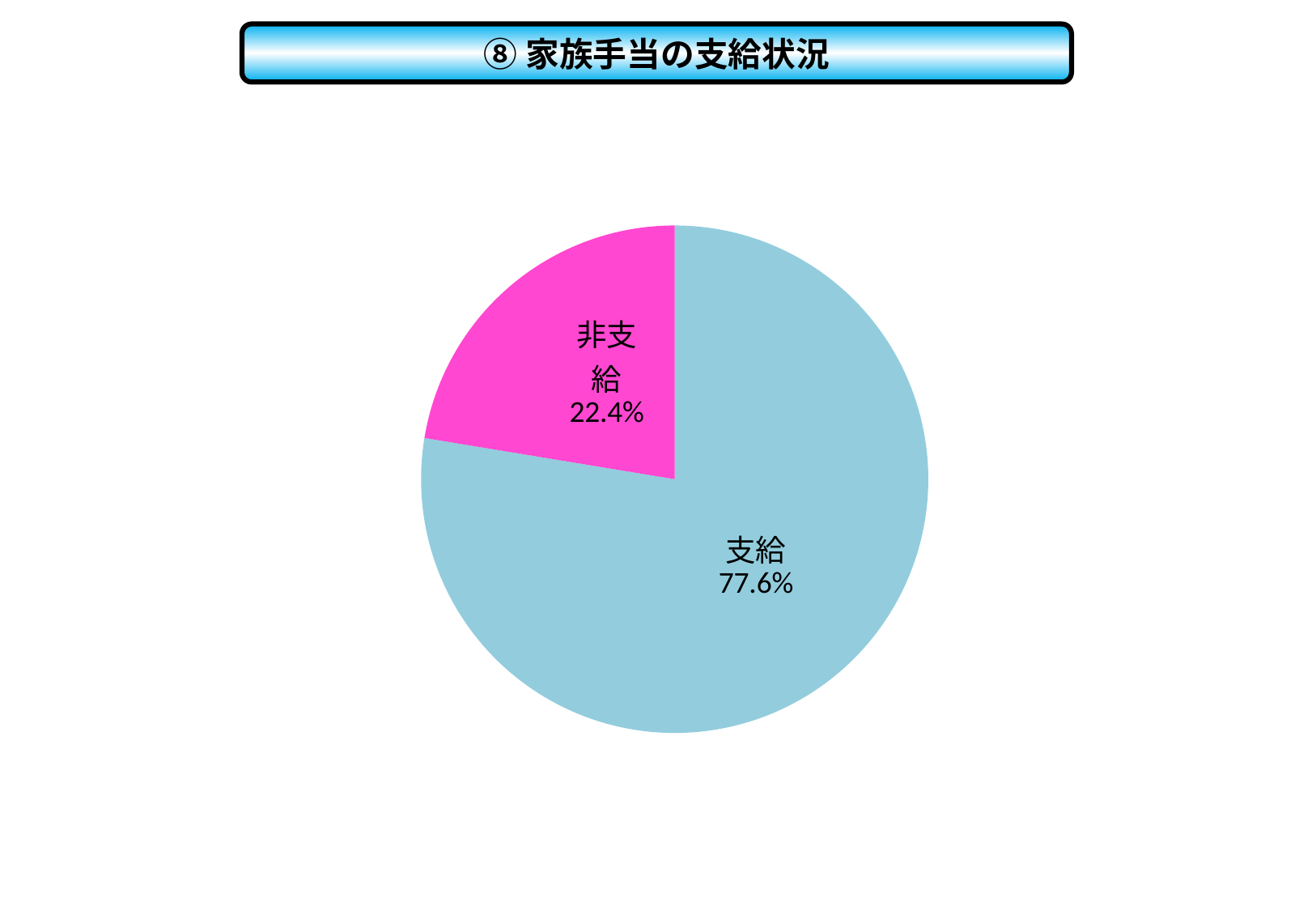
What share of the pie does the 非支給 slice represent? 22.4% What colour is the 非支給 slice of the pie chart? pink (magenta) What is the difference in percentage points between the 支給 slice and the 非支給 slice? 55.2 What percentage of the pie chart is labelled 支給? 77.6% What percentage of the pie chart is labelled 非支給? 22.4% What kind of chart is shown on the slide? pie chart How many slices does the pie chart have? 2 Which slice of the pie chart is the smallest? 非支給 What is the title shown above the chart? ⑧ 家族手当の支給状況 Which slice of the pie chart is the largest? 支給 Which slice is larger, 支給 or 非支給? 支給